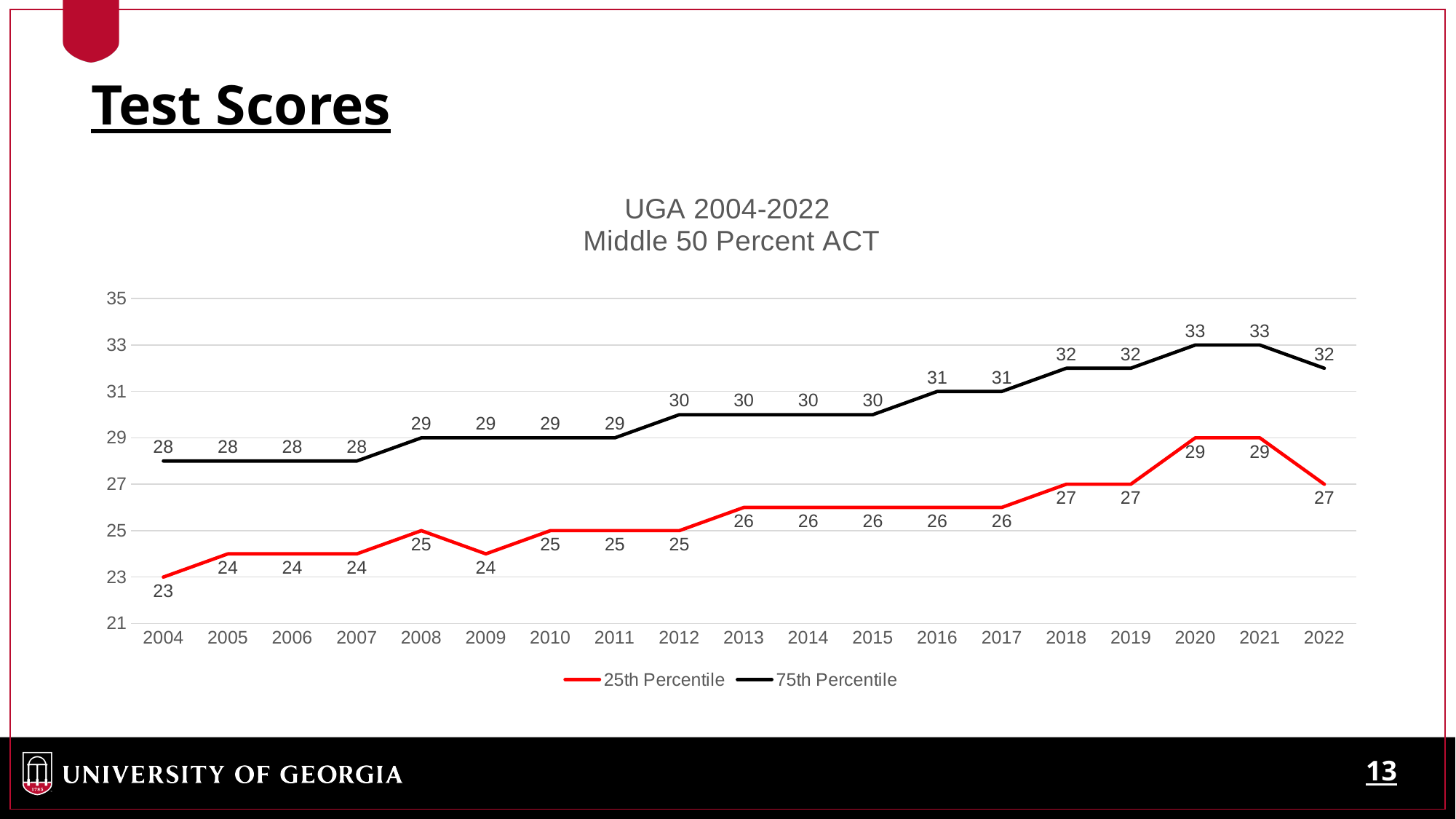
Which is larger, the 25th Percentile score in 2020 or the 75th Percentile score in 2004? 25th Percentile score in 2020 What kind of chart is shown on the slide? Line chart What is the 75th Percentile ACT score for 2004? 28 In which years does the 75th Percentile reach its highest value of 33? 2020 and 2021 What is the 25th Percentile ACT score for 2009? 24 By how much did the 25th Percentile score increase from 2004 to 2020? 6 How many series does the legend list? 2 In which year is the 25th Percentile at its lowest value? 2004 What is the difference between the 75th Percentile and 25th Percentile scores in 2022? 5 What is the 25th Percentile ACT score for 2022? 27 What colour is the line for the 25th Percentile series? Red How many years are shown on the x axis? 19